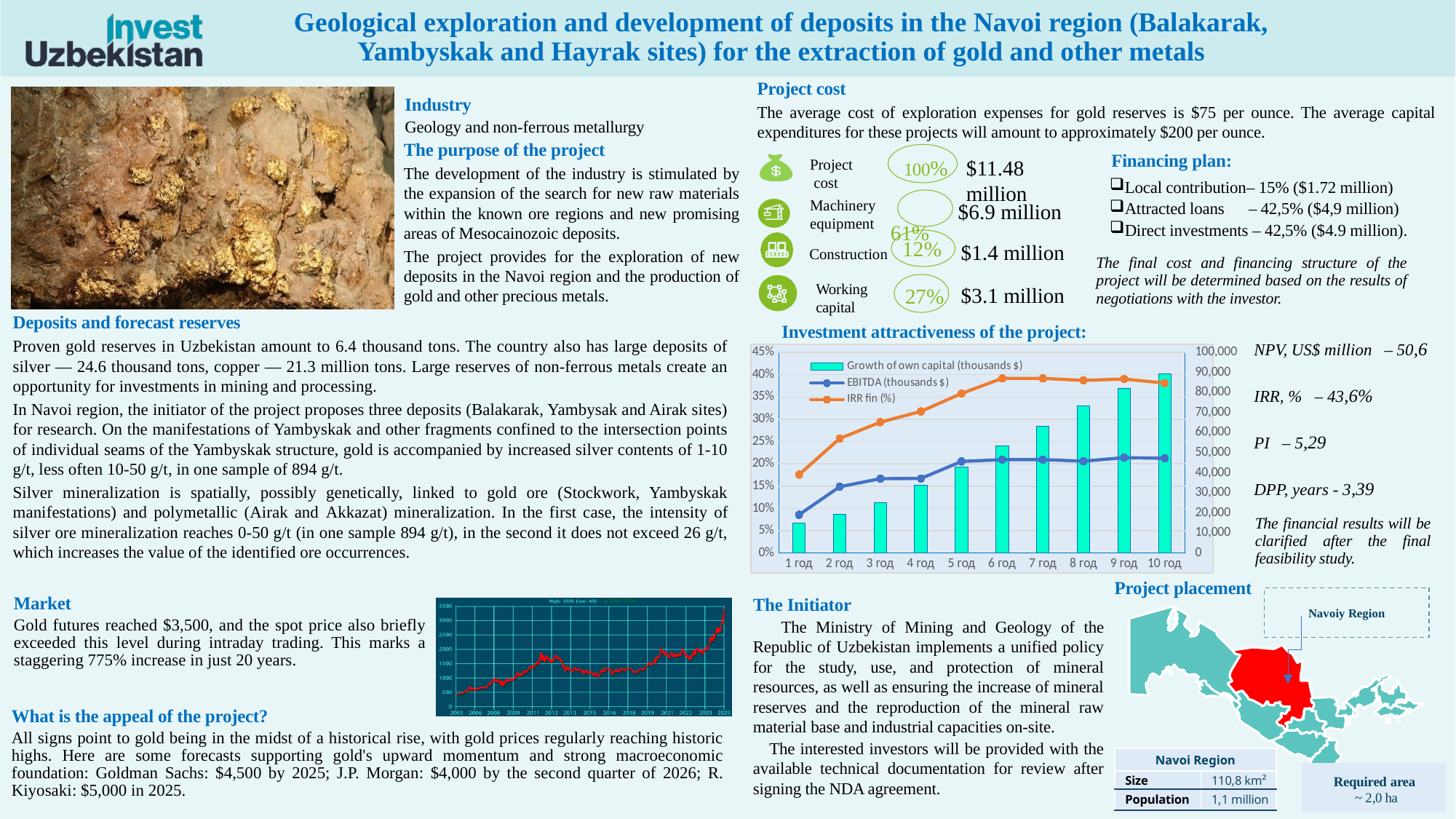
How many year categories are shown on the x axis of the 'Investment attractiveness of the project' chart? 10 How many series does the legend of the 'Investment attractiveness of the project' chart list? 3 In the 'Investment attractiveness of the project' chart, what colour is the IRR fin (%) line? Orange What is the title of the chart on the slide? Investment attractiveness of the project In the 'Investment attractiveness of the project' chart, is the Growth of own capital for 10 год greater or less than 80,000? greater What kind of chart is the 'Investment attractiveness of the project' chart? Bar and line chart In the 'Investment attractiveness of the project' chart, which year has the highest Growth of own capital? 10 год In the 'Investment attractiveness of the project' chart, which year has the lowest Growth of own capital? 1 год In the 'Investment attractiveness of the project' chart, is the IRR fin (%) for 1 год greater or less than 20%? less In the 'Investment attractiveness of the project' chart, which year has a larger Growth of own capital, 6 год or 9 год? 9 год In the 'Investment attractiveness of the project' chart, is the Growth of own capital for 1 год greater or less than 20,000? less In the 'Investment attractiveness of the project' chart, does Growth of own capital rise or fall from 1 год to 10 год? Rise